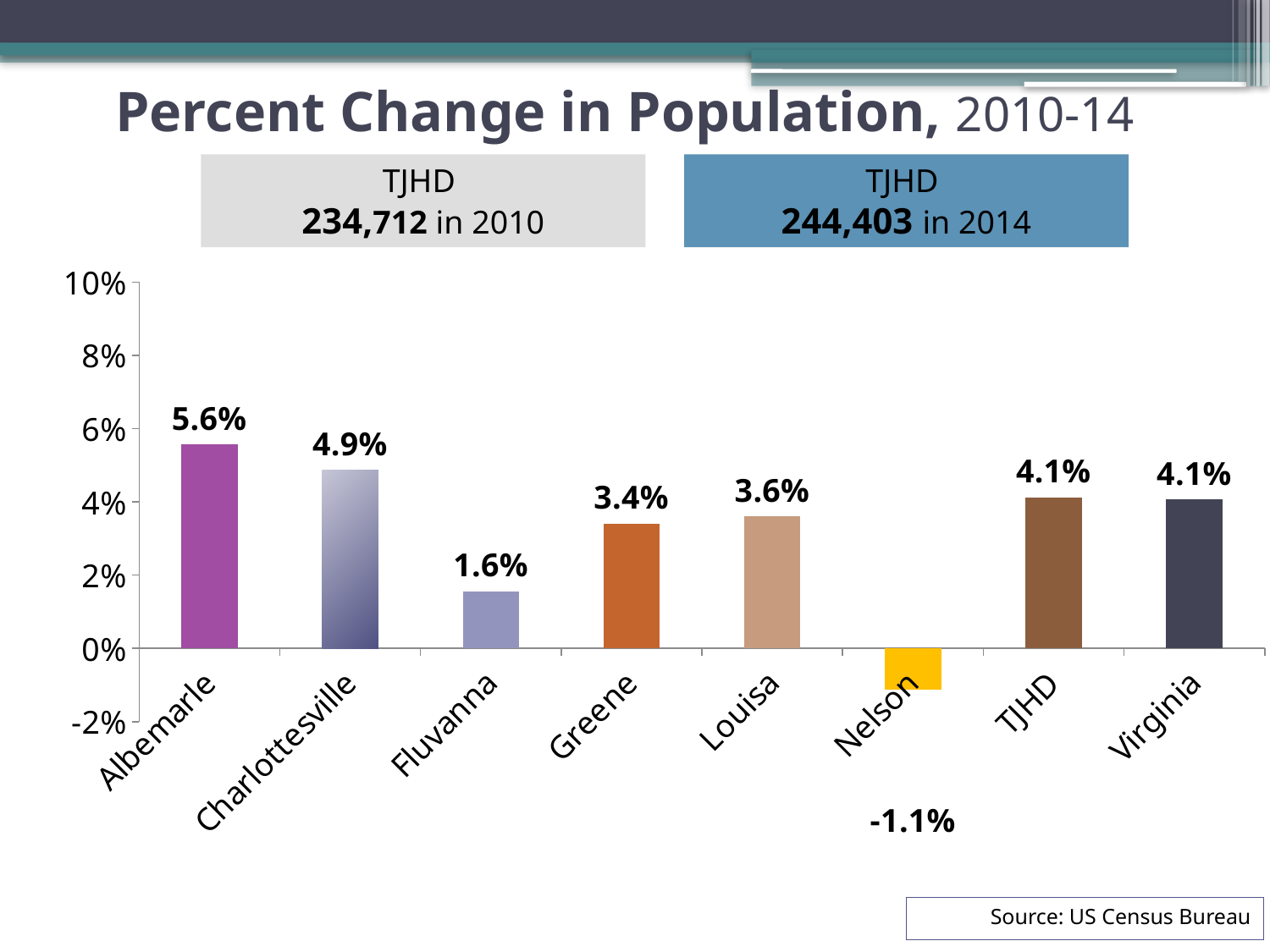
What is the percent change in population for Albemarle? 5.6% What is the percent change in population for Nelson? -1.1% Which category has the highest percent change in population? Albemarle What is the percent change in population for Fluvanna? 1.6% Is the value for Charlottesville greater or less than 4%? greater Which has a larger percent change in population, Greene or Louisa? Louisa What kind of chart is shown on the slide? Bar chart What is the percent change in population for TJHD? 4.1% How many categories are shown on the x axis of the chart? 8 Which category has the lowest percent change in population? Nelson What is the difference between the percent change for Albemarle and Charlottesville? 0.7% What is the title of the chart on the slide? Percent Change in Population, 2010-14